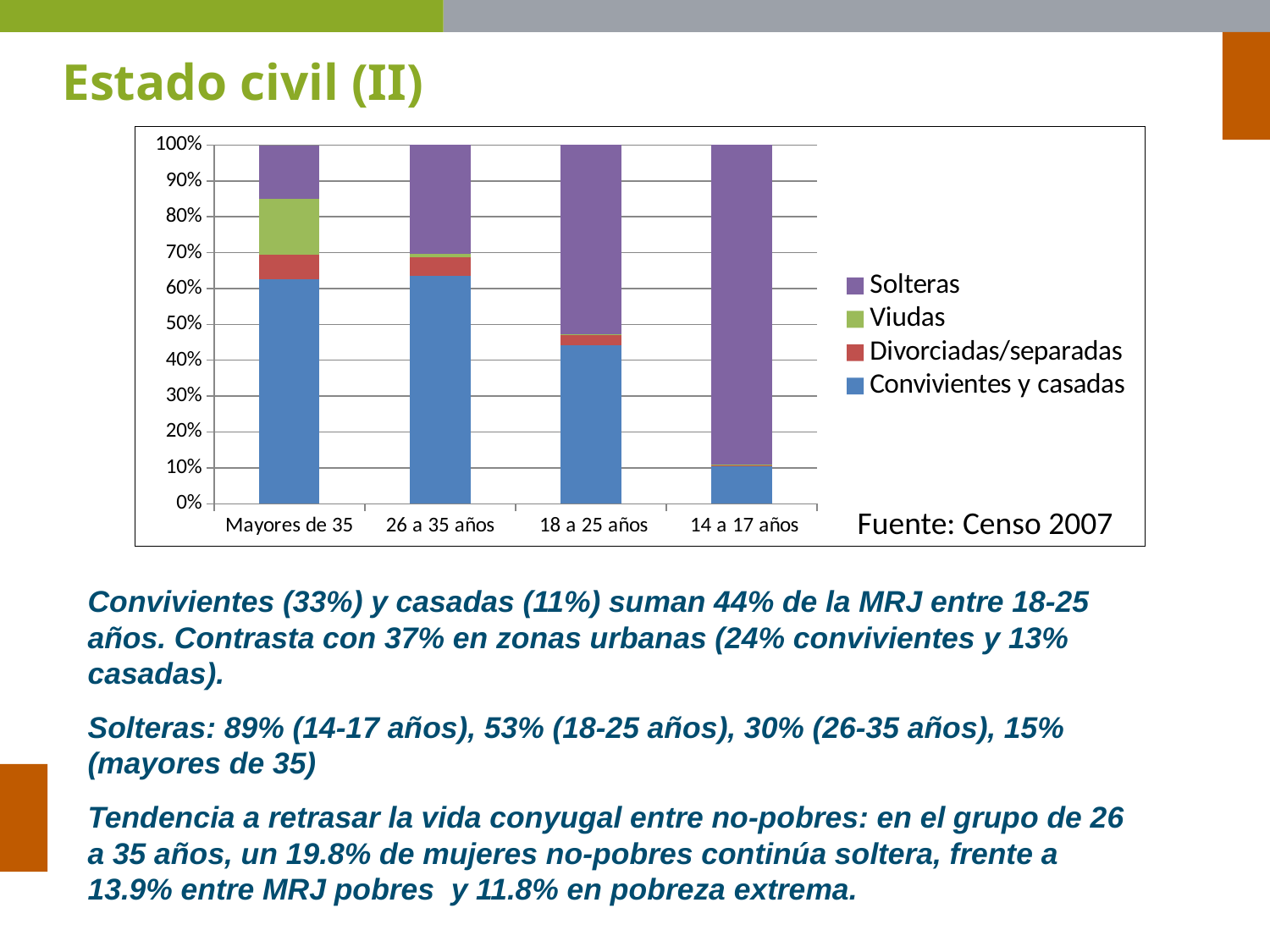
Is the value for Convivientes y casadas in the Mayores de 35 group greater or less than 50%? greater Is the Viudas segment for Mayores de 35 greater or less than 10%? greater What kind of chart is shown on the slide? Stacked bar chart According to the slide, what is the Solteras percentage for the 14 a 17 años group? 89% Is the Solteras segment for 18 a 25 años greater or less than 50%? greater Is the Solteras share larger for 14 a 17 años or for Mayores de 35? 14 a 17 años Which age group has the smallest Convivientes y casadas segment? 14 a 17 años How many series does the chart legend list? 4 How many age categories are shown on the x axis of the chart? 4 Which age group has the largest Solteras segment? 14 a 17 años Moving along the x axis from Mayores de 35 to 14 a 17 años, does the Solteras share rise or fall? Rise